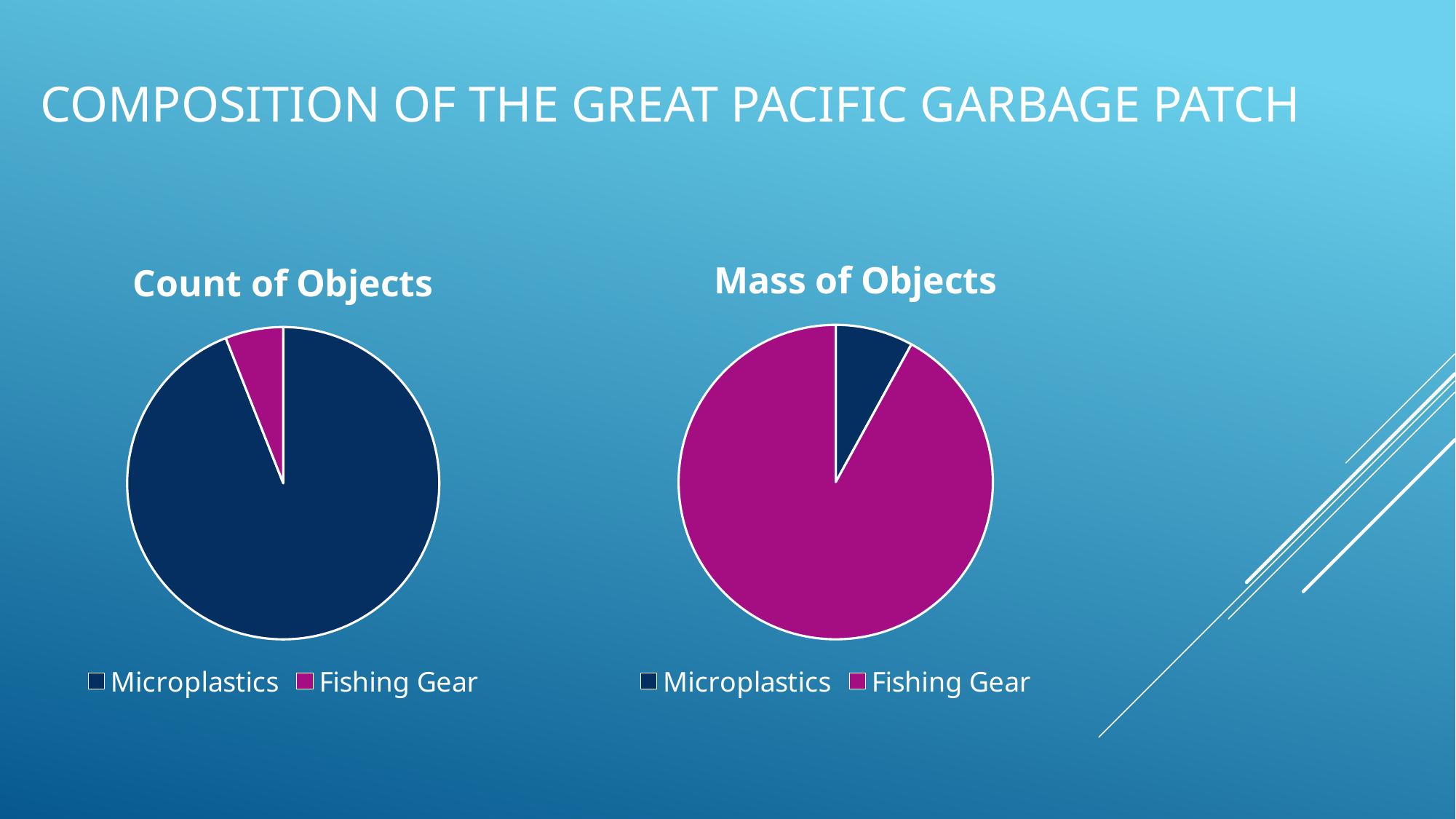
How many categories does the "Count of Objects" pie chart show? 2 In the "Mass of Objects" chart, is the slice for Microplastics or Fishing Gear larger? Fishing Gear In the "Count of Objects" chart, which category has the largest slice? Microplastics In the "Mass of Objects" chart, which category has the largest slice? Fishing Gear In the "Count of Objects" chart, is the slice for Microplastics or Fishing Gear larger? Microplastics How many entries does the legend of the "Mass of Objects" chart list? 2 What kind of chart is the "Count of Objects" chart? pie chart In the "Mass of Objects" chart, which category has the smallest slice? Microplastics In the "Mass of Objects" chart, what colour represents Fishing Gear? magenta What is the title of the chart on the left of the slide? Count of Objects In the "Count of Objects" chart, which category has the smallest slice? Fishing Gear What kind of chart is the "Mass of Objects" chart? pie chart